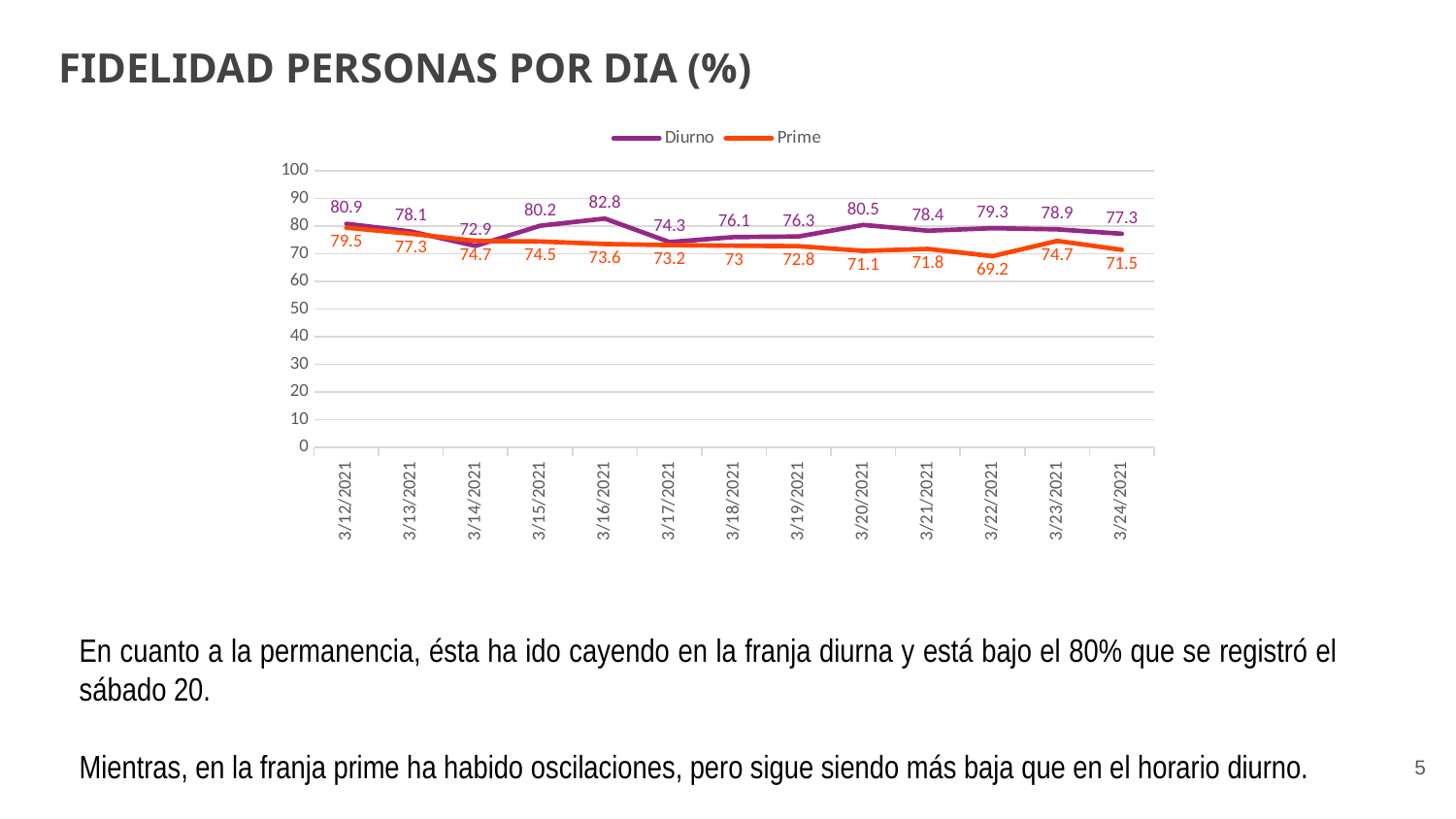
What kind of chart is shown on the slide? Line chart What is the Prime value on 3/22/2021? 69.2 On which date does the Diurno series reach its highest value? 3/16/2021 What is the title of the chart? FIDELIDAD PERSONAS POR DIA (%) How many dates are plotted on the x axis? 13 On which date does the Prime series reach its lowest value? 3/22/2021 How many series does the legend list? 2 Which series has the higher value on 3/14/2021, Diurno or Prime? Prime What is the Prime value on 3/12/2021? 79.5 What is the Diurno value on 3/16/2021? 82.8 What is the difference between the Diurno and Prime values on 3/16/2021? 9.2 On which date does the Diurno series have its lowest value? 3/14/2021